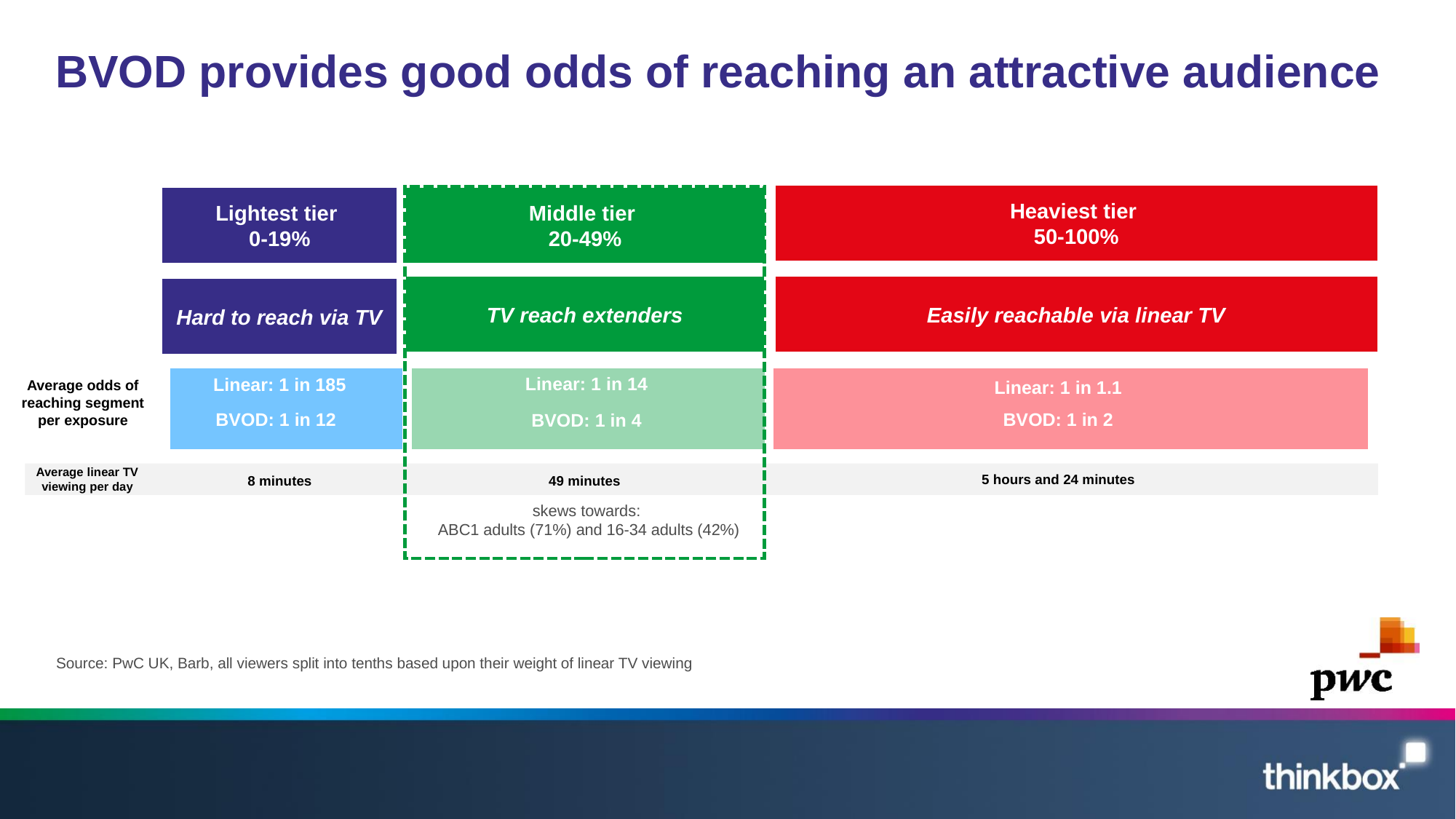
What are the average odds of reaching the heaviest tier segment per exposure via linear TV? 1 in 1.1 Which tier is described as 'Hard to reach via TV'? Lightest tier How many tiers of linear TV viewing are shown on the slide? 3 What are the average odds of reaching the heaviest tier segment per exposure via BVOD? 1 in 2 What is the average linear TV viewing per day for the lightest tier? 8 minutes What are the average odds of reaching the lightest tier segment per exposure via BVOD? 1 in 12 What are the average odds of reaching the lightest tier segment per exposure via linear TV? 1 in 185 What is the average linear TV viewing per day for the middle tier? 49 minutes What are the average odds of reaching the middle tier segment per exposure via BVOD? 1 in 4 What are the average odds of reaching the middle tier segment per exposure via linear TV? 1 in 14 What percentage range of linear TV viewing defines the middle tier? 20-49% What is the average linear TV viewing per day for the heaviest tier? 5 hours and 24 minutes